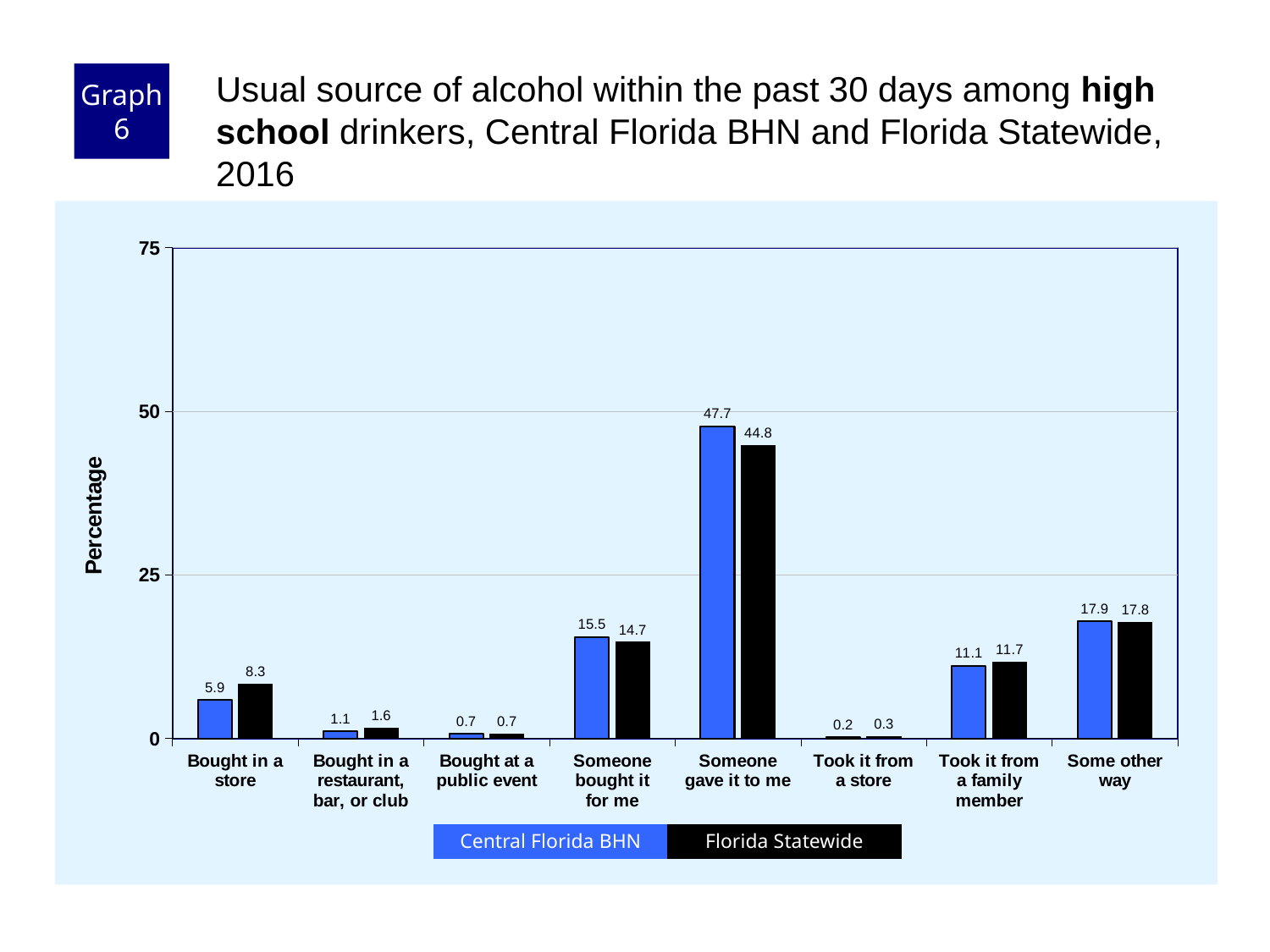
What is the Florida Statewide value for "Took it from a family member"? 11.7 What is the Florida Statewide value for "Bought in a store"? 8.3 What kind of chart is shown on the slide? bar chart Which category has the highest Central Florida BHN value? Someone gave it to me Is the Central Florida BHN value for "Someone bought it for me" greater or less than 25? less How many categories are shown on the x axis? 8 Which category has the lowest Florida Statewide value? Took it from a store For "Bought in a store", which is larger: the Central Florida BHN value or the Florida Statewide value? Florida Statewide What is the difference between the Central Florida BHN and Florida Statewide values for "Someone gave it to me"? 2.9 What is the label of the y axis? Percentage What is the Central Florida BHN value for "Someone gave it to me"? 47.7 How many series does the legend list? 2